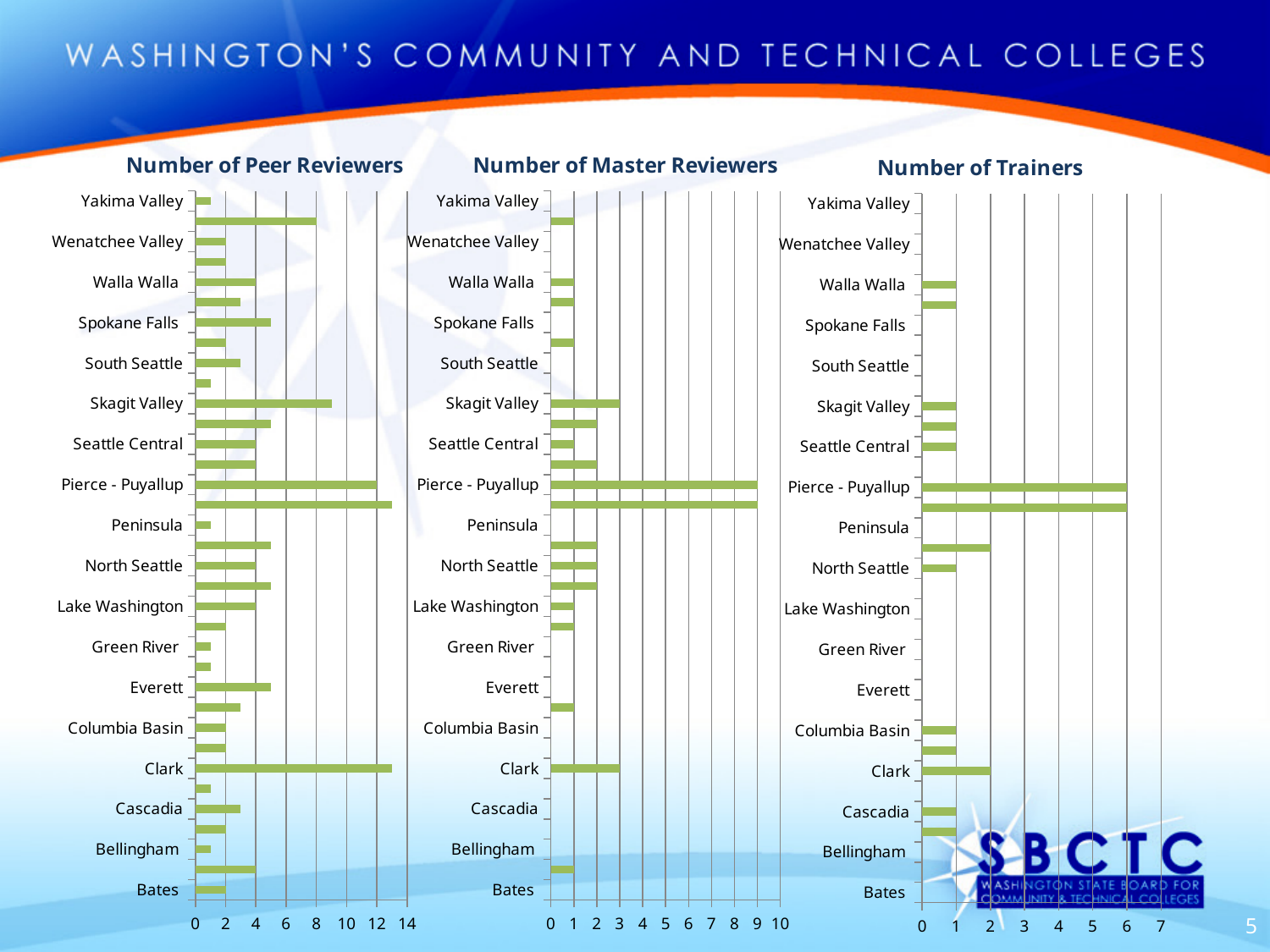
In the Number of Trainers chart, what is the value for Clark? 2 In the Number of Trainers chart, which college has the highest value? Pierce - Puyallup In the Number of Master Reviewers chart, which college has the highest value? Pierce - Puyallup What kind of chart is the Number of Peer Reviewers chart? bar chart In the Number of Master Reviewers chart, which is larger, the value for Skagit Valley or the value for Walla Walla? Skagit Valley In the Number of Master Reviewers chart, what is the value for Clark? 3 In the Number of Trainers chart, which is larger, the value for Pierce - Puyallup or the value for Clark? Pierce - Puyallup In the Number of Trainers chart, what is the value for Pierce - Puyallup? 6 In the Number of Master Reviewers chart, what is the value for Pierce - Puyallup? 9 In the Number of Peer Reviewers chart, is the value for Clark greater or less than 10? greater What is the title of the middle chart on the slide? Number of Master Reviewers In the Number of Trainers chart, what is the value for Walla Walla? 1